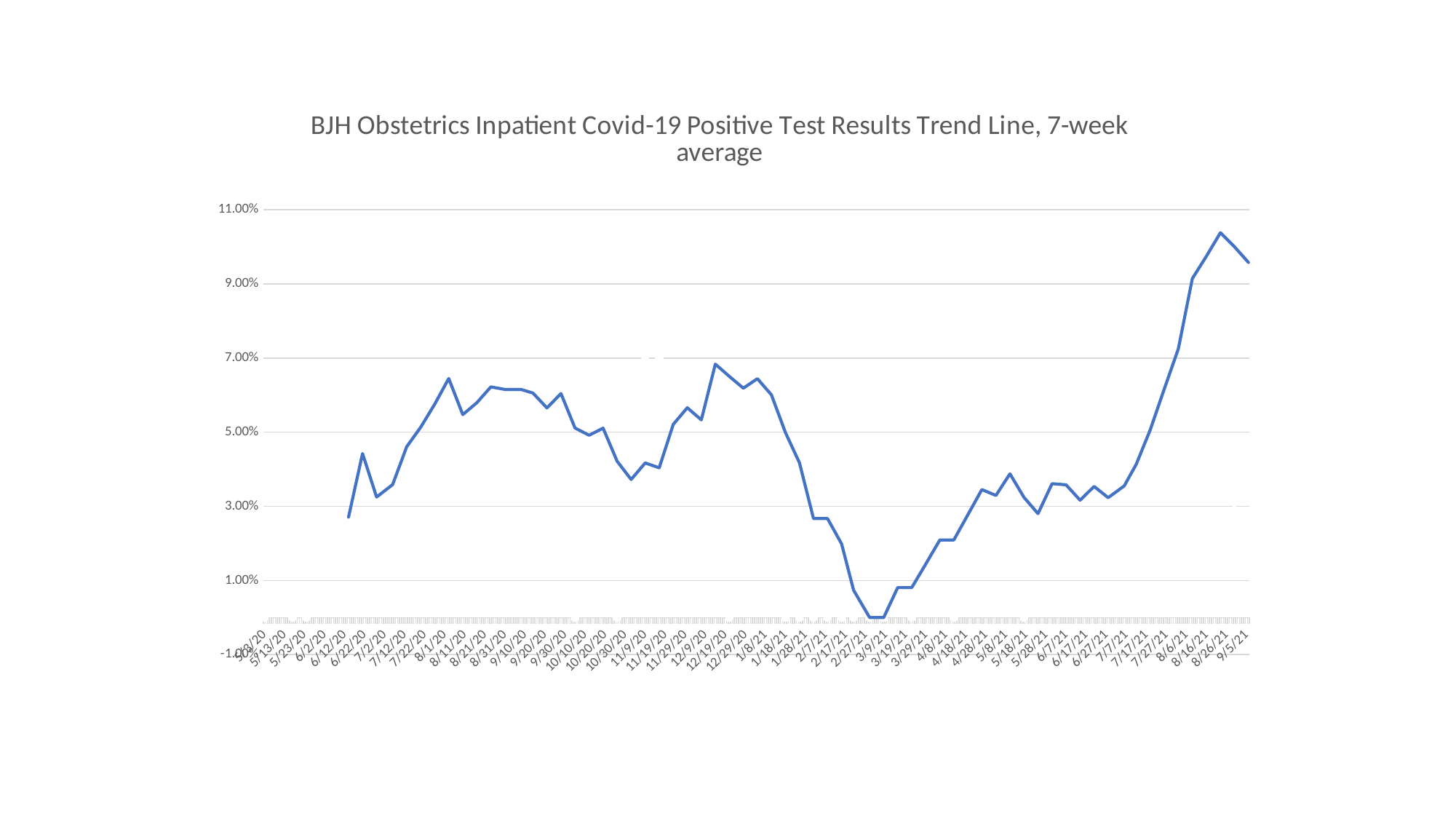
Around which date label does the trend line reach its highest value? 8/26/21 What colour is the trend line in the chart? blue Is the value at 3/9/21 greater or less than 1.00%? less Does the trend line rise or fall between 1/8/21 and 2/27/21? fall Which is larger, the value at 8/26/21 or the value at 12/19/20? 8/26/21 Is the value at 6/22/20 greater or less than 3.00%? greater What kind of chart is shown on the slide? line chart What is the title of the chart? BJH Obstetrics Inpatient Covid-19 Positive Test Results Trend Line, 7-week average Is the value at 9/5/21 greater or less than 9.00%? greater Does the trend line rise or fall between 7/7/21 and 8/26/21? rise